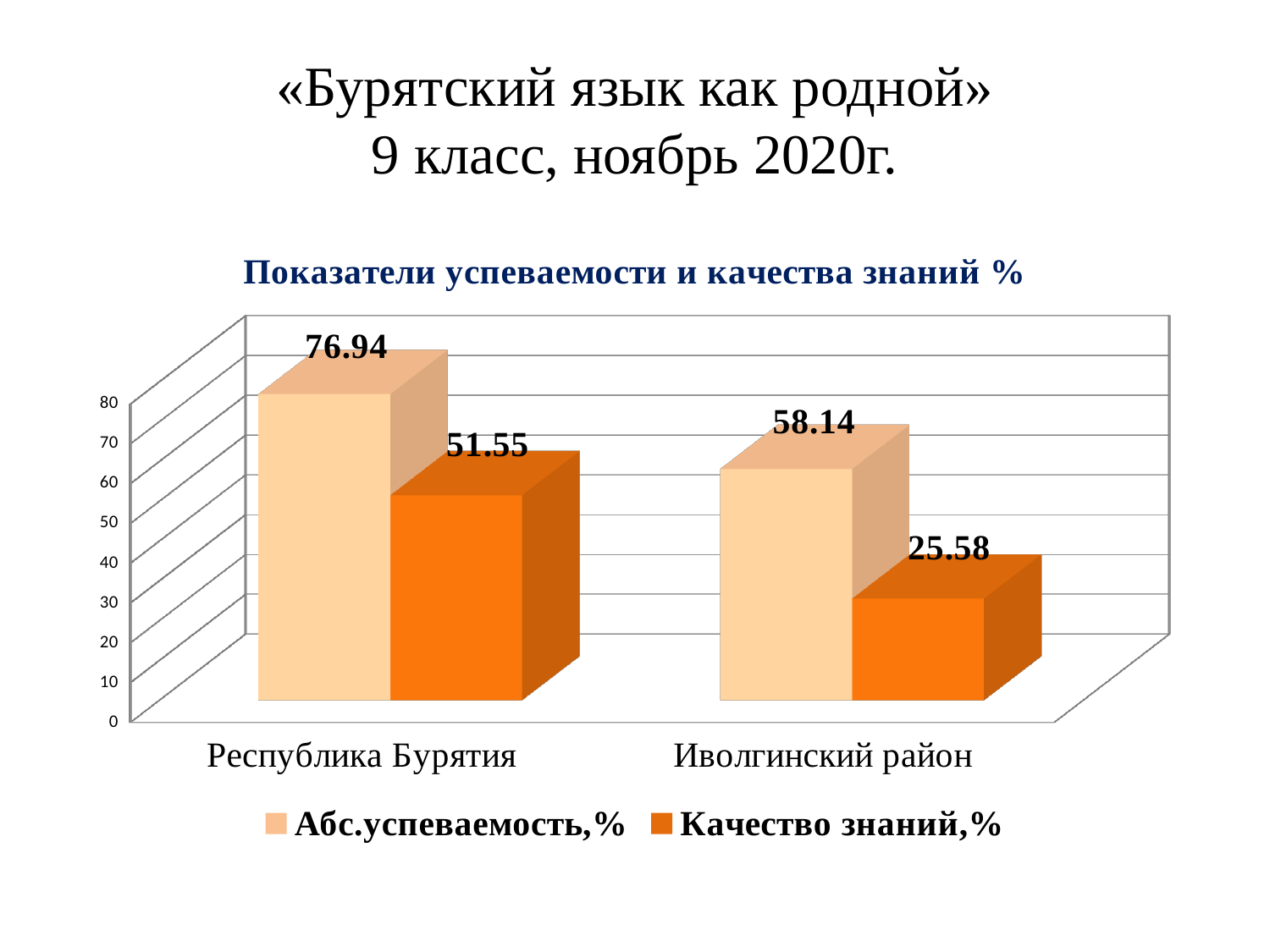
What is the value of Абс.успеваемость,% for Иволгинский район? 58.14 What is the difference between Абс.успеваемость,% and Качество знаний,% for Иволгинский район? 32.56 What is the value of Качество знаний,% for Республика Бурятия? 51.55 How many series does the legend list? 2 Which is larger: Качество знаний,% for Республика Бурятия or Абс.успеваемость,% for Иволгинский район? Абс.успеваемость,% for Иволгинский район How many categories are shown on the x axis? 2 What kind of chart is shown on the slide? Bar chart Which category has the lowest Качество знаний,% value? Иволгинский район What is the value of Абс.успеваемость,% for Республика Бурятия? 76.94 What is the difference between Абс.успеваемость,% for Республика Бурятия and for Иволгинский район? 18.8 Which category has the highest Абс.успеваемость,% value? Республика Бурятия What is the value of Качество знаний,% for Иволгинский район? 25.58